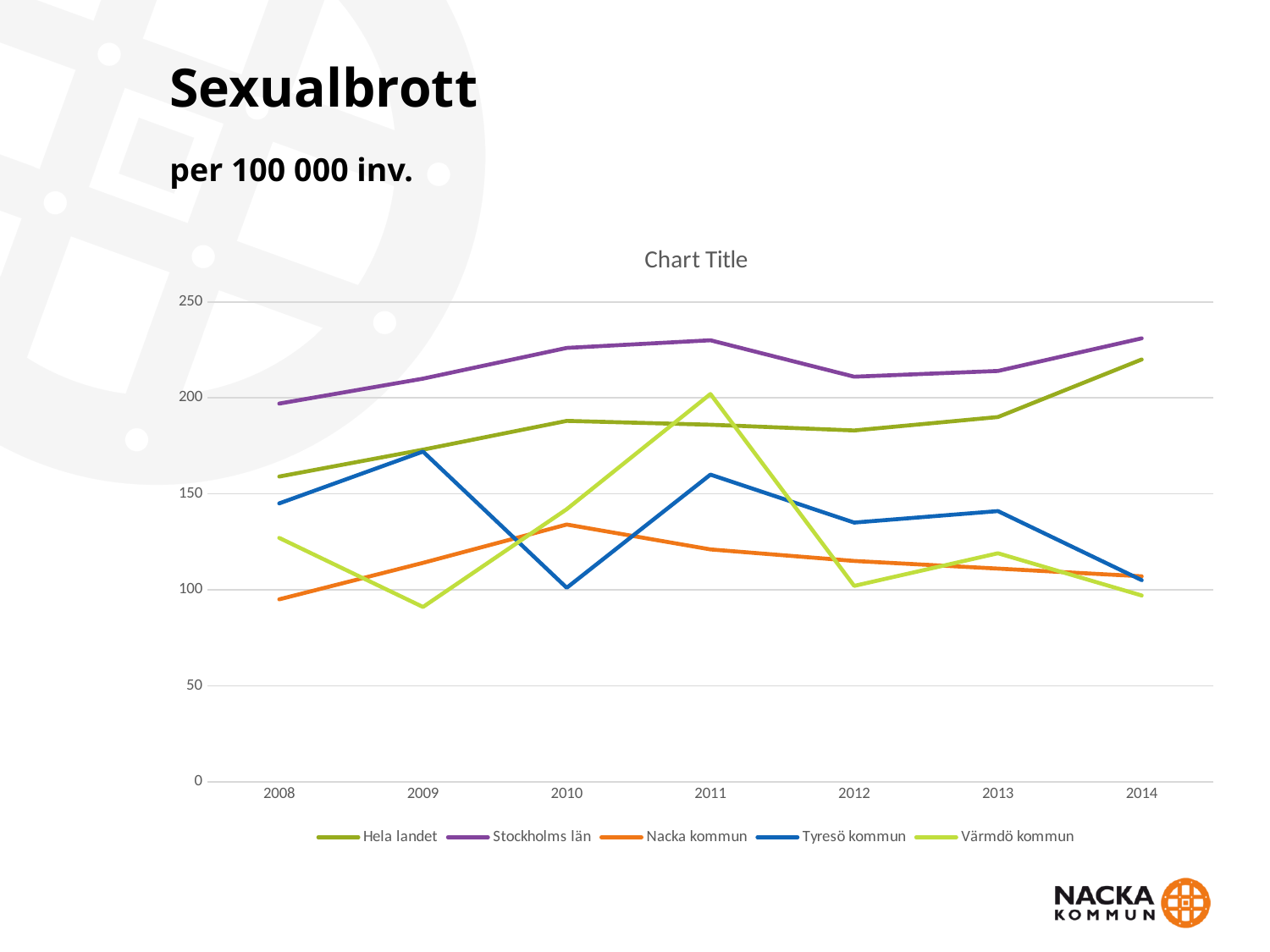
In which year does Värmdö kommun reach its highest value? 2011 Which series has the lowest value in 2008? Nacka kommun What kind of chart is shown on the slide? line chart Which series has the highest value in 2011? Stockholms län How many years are shown on the x axis? 7 What is the title printed above the chart? Chart Title Is the value for Värmdö kommun in 2009 greater or less than 100? less Does the Nacka kommun line rise or fall from 2010 to 2014? fall Which is larger in 2014, Stockholms län or Hela landet? Stockholms län Is the value for Tyresö kommun in 2011 greater or less than 150? greater How many series does the legend list? 5 Is the value for Stockholms län in 2011 greater or less than 200? greater